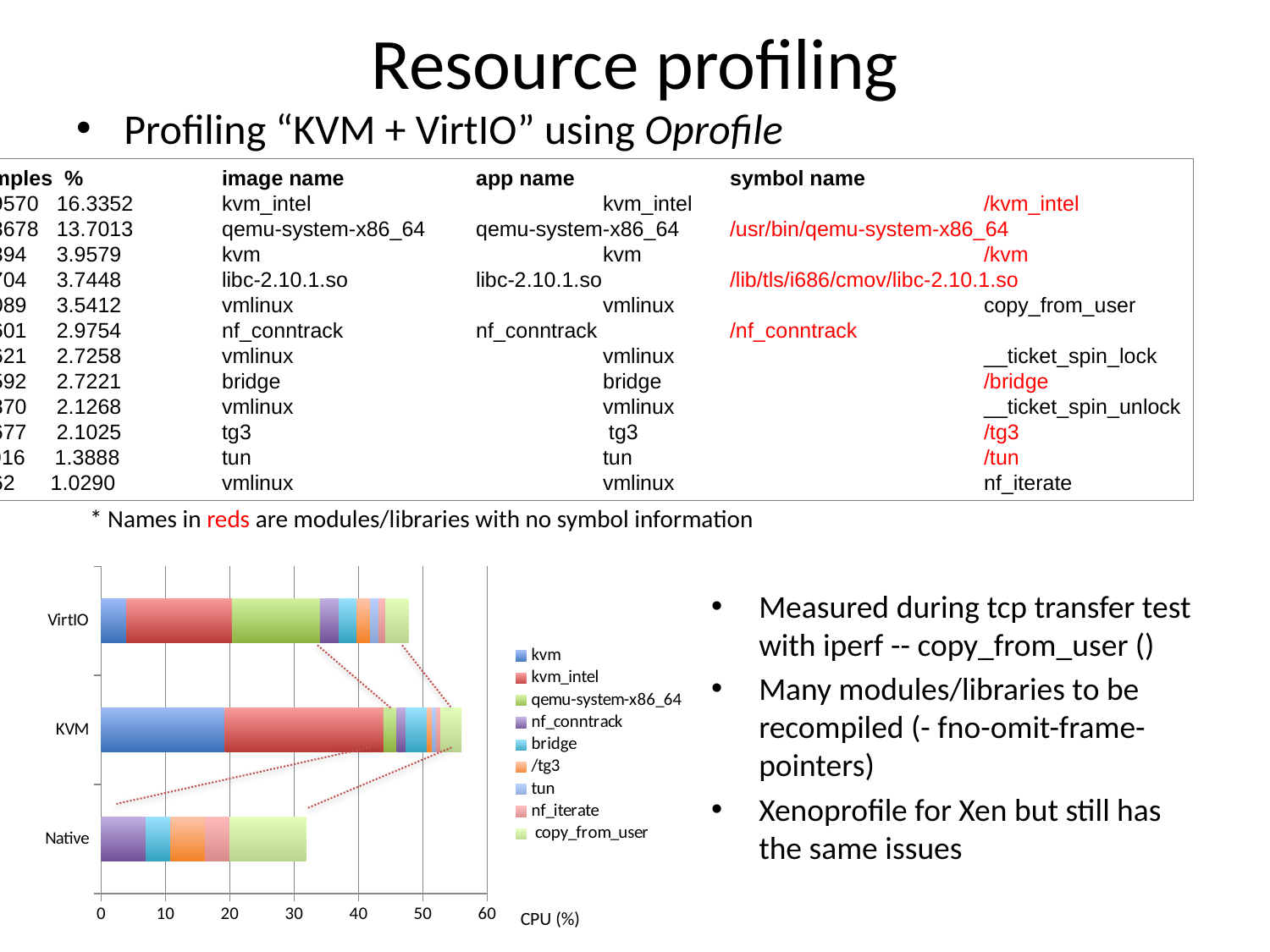
Which has a longer total bar, KVM or VirtIO? KVM Which has a longer total bar, VirtIO or Native? VirtIO How many series does the chart's legend list? 9 Is the total bar length for VirtIO greater or less than 40? greater How many categories are shown on the vertical axis of the chart? 3 Which category has the longest total bar in the chart? KVM Is the total bar length for Native greater or less than 40? less Is the total bar length for KVM greater or less than 50? greater Which category has the shortest total bar in the chart? Native What kind of chart is shown on the slide? stacked bar chart What is the label of the horizontal axis of the chart? CPU (%) Which series is listed first in the chart's legend? kvm